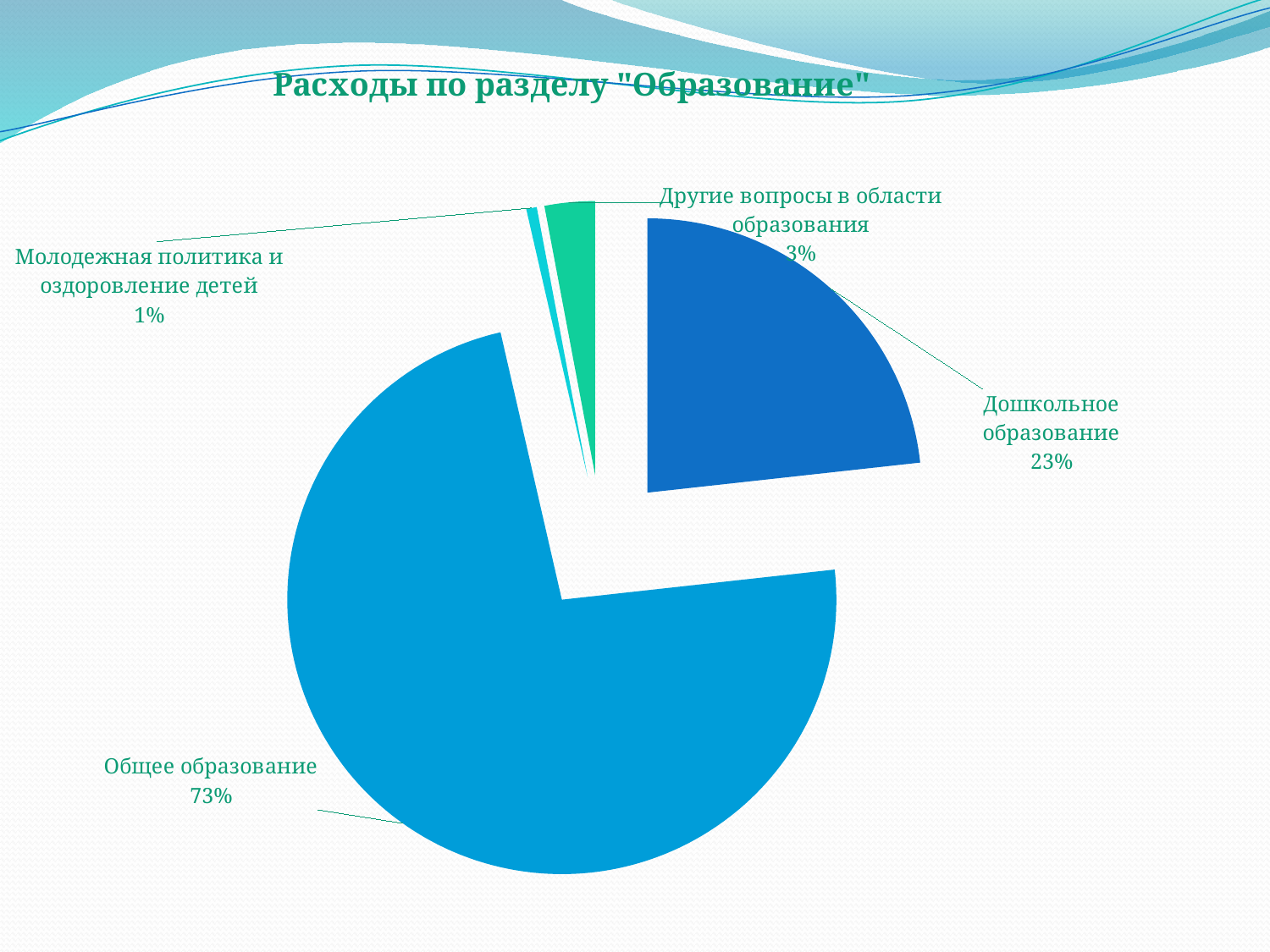
What kind of chart is shown on the slide? Pie chart What is the value shown for "Другие вопросы в области образования"? 3% How many slices does the pie chart have? 4 What share of the pie does "Дошкольное образование" take? 23% Which category has the smallest share of the pie? Молодежная политика и оздоровление детей What is the title of the chart? Расходы по разделу "Образование" What is the value shown for "Молодежная политика и оздоровление детей"? 1% What share of the pie does "Общее образование" take? 73% What is the difference in percentage points between "Общее образование" and "Дошкольное образование"? 50 Which category has the largest share of the pie? Общее образование Which is larger: "Дошкольное образование" or "Другие вопросы в области образования"? Дошкольное образование What is the combined share of "Молодежная политика и оздоровление детей" and "Другие вопросы в области образования"? 4%